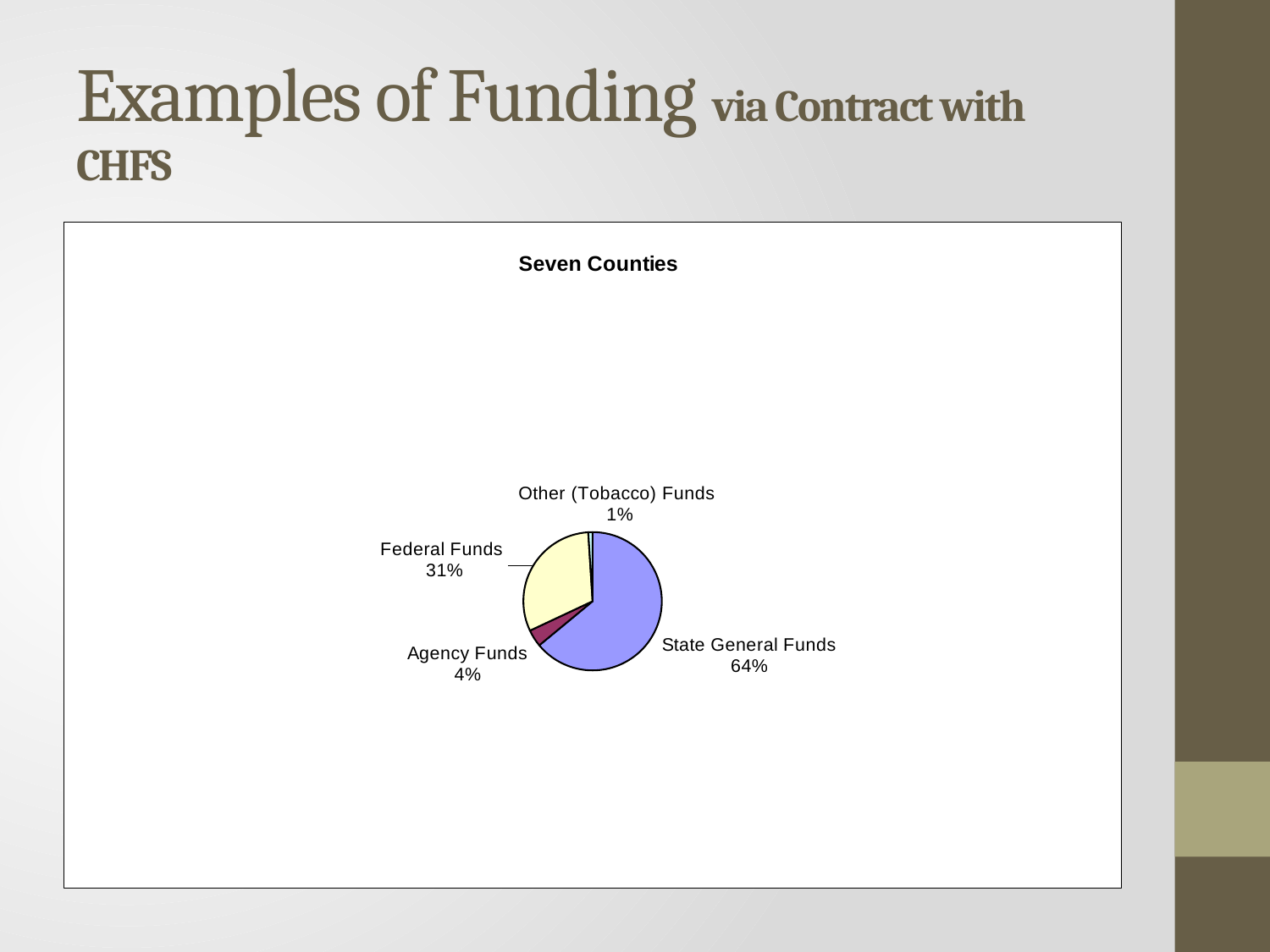
What share of the pie is State General Funds? 64% What is the difference in percentage points between State General Funds and Federal Funds? 33 What percentage is shown for Other (Tobacco) Funds? 1% What is the title of the chart? Seven Counties Which funding source has the smallest share of the pie? Other (Tobacco) Funds What percentage is shown for Agency Funds? 4% What is the combined percentage of Federal Funds and Agency Funds? 35% What type of chart is shown on the slide? pie chart What percentage is shown for Federal Funds? 31% How many slices does the pie chart have? 4 Which funding source has the largest share of the pie? State General Funds Which is larger, Agency Funds or Other (Tobacco) Funds? Agency Funds